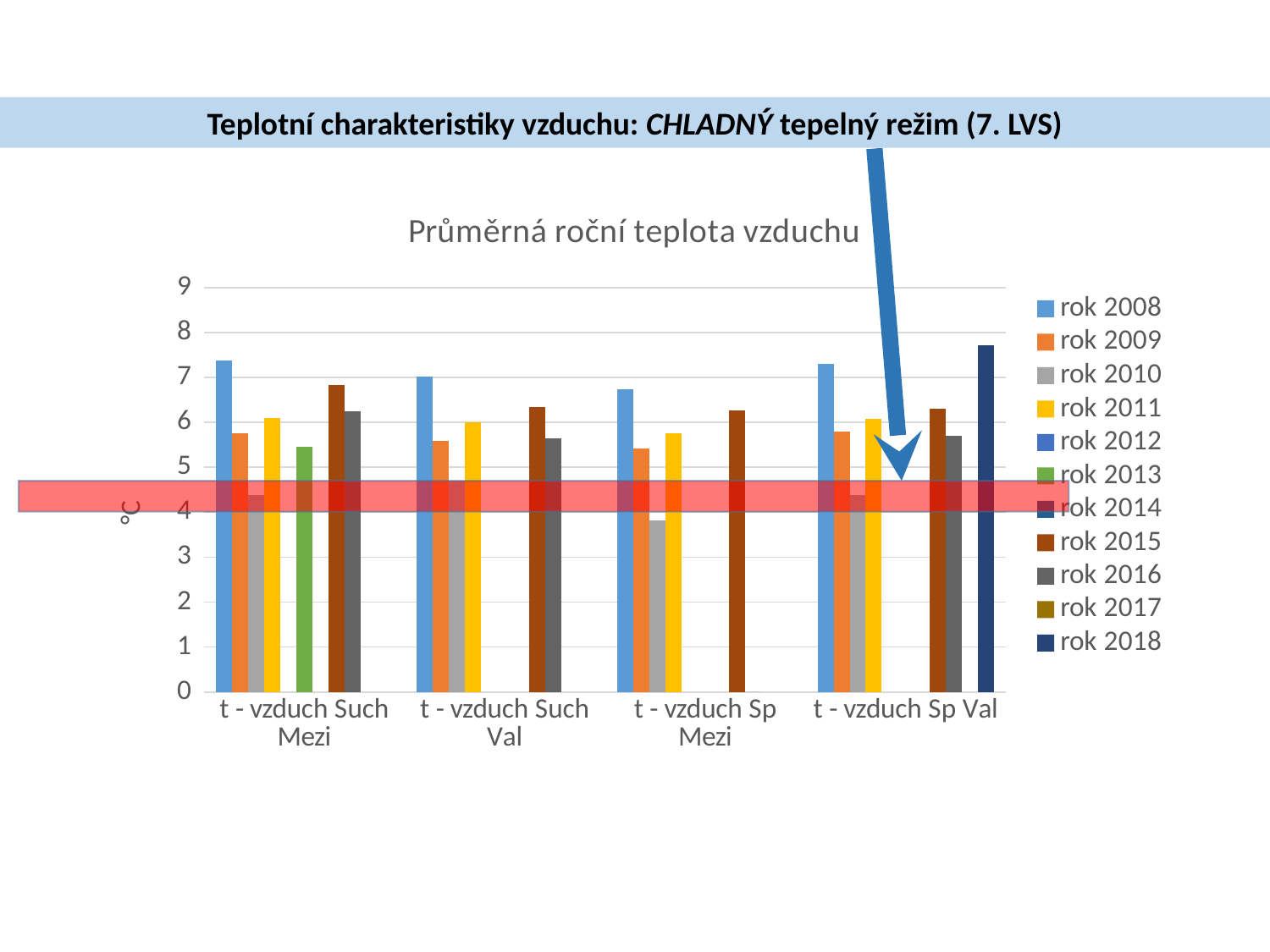
How many series does the legend list? 11 In the category 't - vzduch Such Mezi', which is larger: the value for rok 2008 or rok 2009? rok 2008 Is the value for rok 2018 in the category 't - vzduch Sp Val' greater or less than 7? greater What is the title of the chart? Průměrná roční teplota vzduchu What kind of chart is shown on the slide? bar chart In the category 't - vzduch Sp Val', which series has the highest value? rok 2018 Is the value for rok 2008 in the category 't - vzduch Such Mezi' greater or less than 7? greater What unit is shown on the vertical axis label? °C How many categories are shown on the x axis? 4 Is the value for rok 2013 in the category 't - vzduch Such Mezi' greater or less than 5? greater